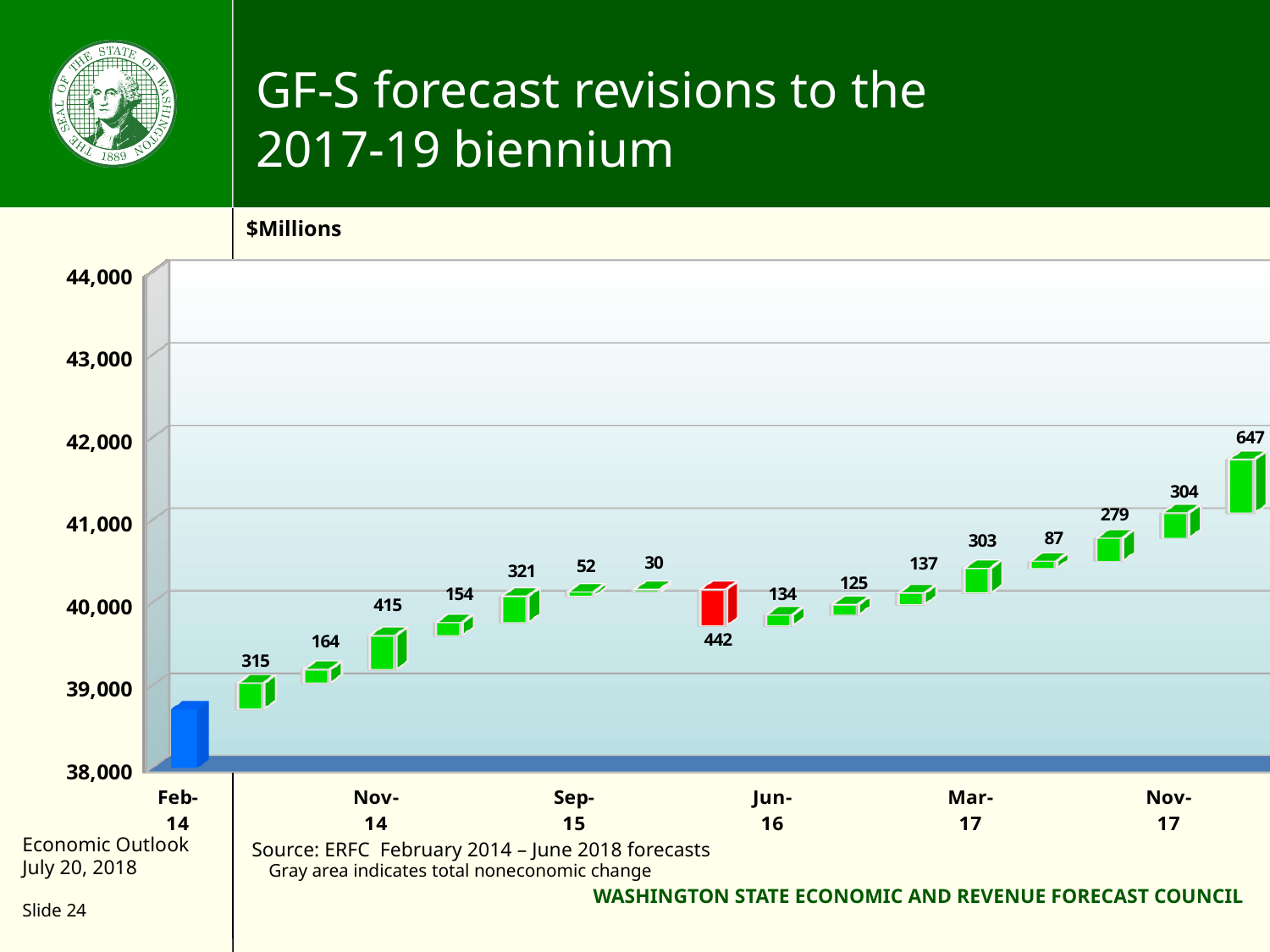
What is the smallest forecast revision value labeled on the chart? 30 What value is labeled on the red (downward) bar in the chart? 442 Do the forecast levels generally rise or fall from left to right across the chart? rise What is the largest forecast revision value labeled on the chart? 647 What kind of chart is shown on the slide? bar chart What is the first x-axis label on the chart? Feb-14 What is the difference between the largest labeled revision (647) and the revision labeled 304 just before it? 343 What is the highest value shown on the y-axis? 44,000 How many labeled forecast revision bars (green and red) are shown on the chart? 16 Is the top of the blue Feb-14 bar greater or less than 39,000? less What unit is shown above the y-axis of the chart? $Millions Which is larger: the first green revision bar (315) or the second green revision bar (164)? 315